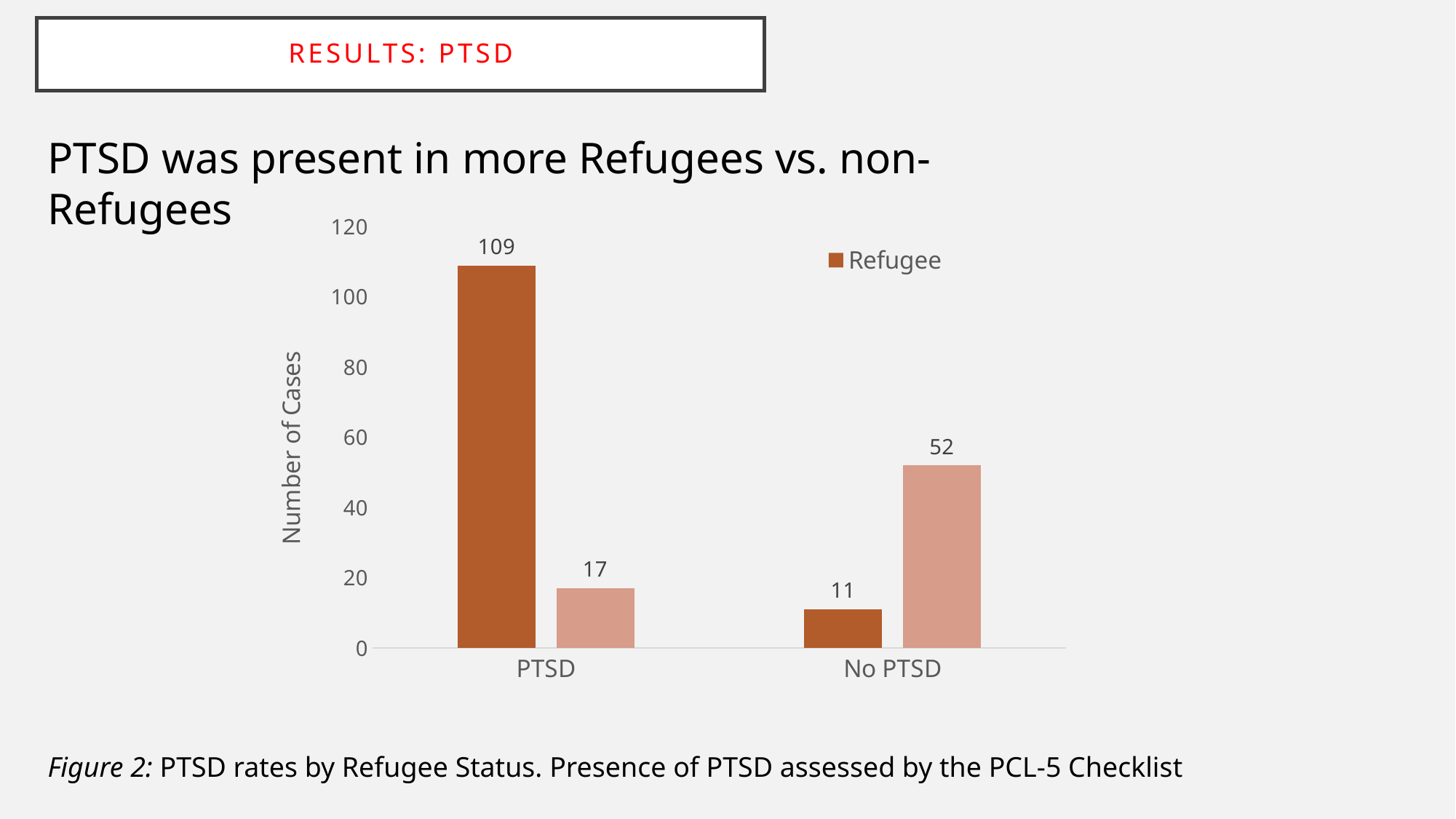
What value is shown on the lighter-coloured bar in the No PTSD category? 52 Which bar has the highest value on the chart? Refugee, PTSD (109) What kind of chart is shown on the slide? Bar chart What value is shown on the lighter-coloured bar in the PTSD category? 17 What is the number of cases for Refugee in the No PTSD category? 11 In the PTSD category, what is the difference between the Refugee bar and the lighter-coloured bar? 92 In the No PTSD category, what is the difference between the lighter-coloured bar and the Refugee bar? 41 For the Refugee series, which category has the larger value, PTSD or No PTSD? PTSD Which bar has the lowest value on the chart? Refugee, No PTSD (11) What is the title of the vertical axis? Number of Cases How many categories are shown on the x axis? 2 What is the number of cases for Refugee in the PTSD category? 109